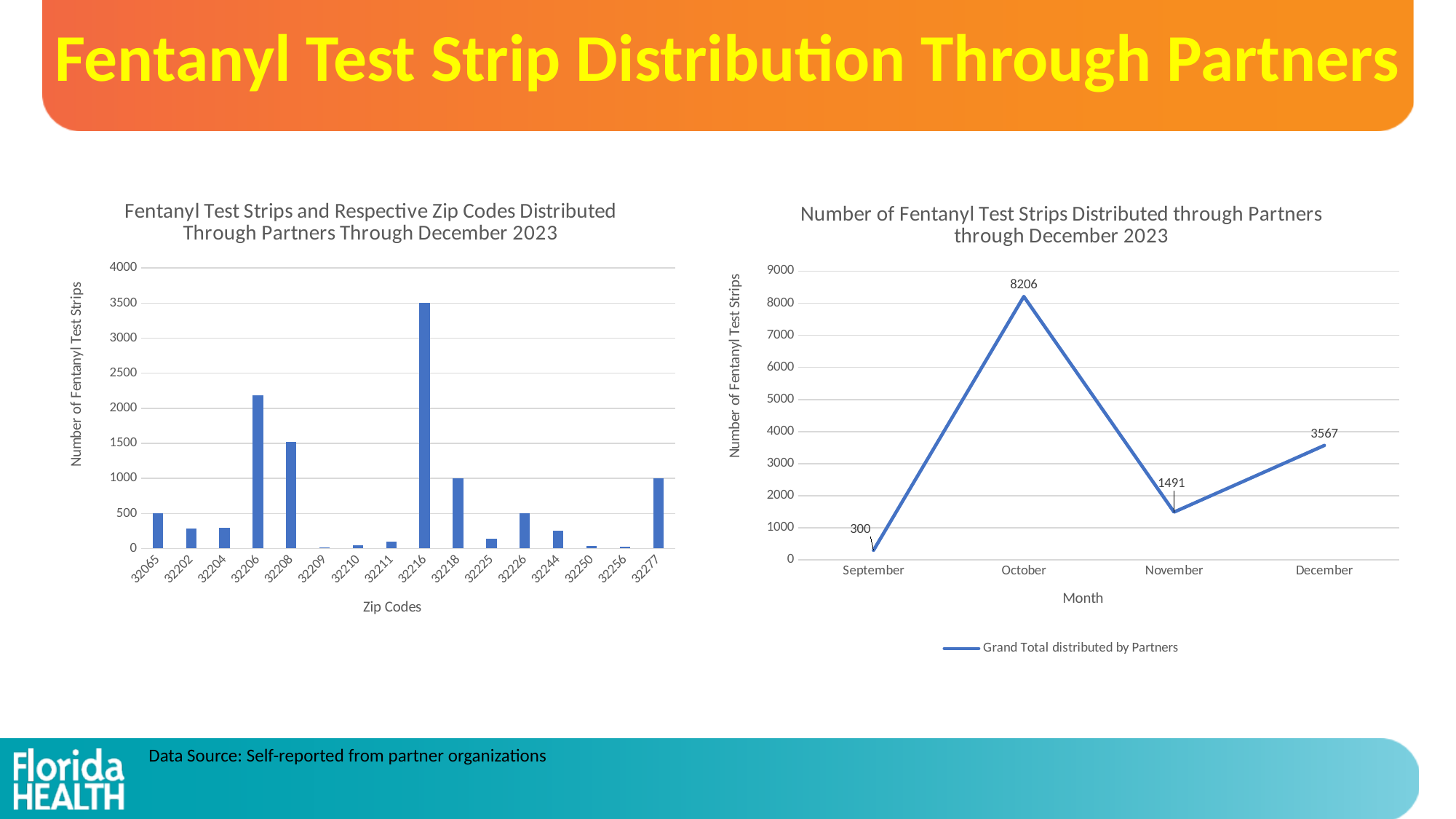
In the chart titled 'Number of Fentanyl Test Strips Distributed through Partners through December 2023', what is the difference between the October and November values? 6715 In the chart titled 'Number of Fentanyl Test Strips Distributed through Partners through December 2023', what is the value for September? 300 In the chart on the left, 'Fentanyl Test Strips and Respective Zip Codes Distributed Through Partners Through December 2023', which zip code has the highest number of test strips? 32216 In the chart titled 'Number of Fentanyl Test Strips Distributed through Partners through December 2023', what is the value for October? 8206 In the chart titled 'Number of Fentanyl Test Strips Distributed through Partners through December 2023', what kind of chart is it? Line chart In the chart titled 'Number of Fentanyl Test Strips Distributed through Partners through December 2023', which month has the highest value? October In the chart titled 'Number of Fentanyl Test Strips Distributed through Partners through December 2023', how many months are plotted? 4 In the chart titled 'Number of Fentanyl Test Strips Distributed through Partners through December 2023', what series name does the legend show? Grand Total distributed by Partners In the chart on the left, 'Fentanyl Test Strips and Respective Zip Codes Distributed Through Partners Through December 2023', how many zip codes are shown on the x axis? 16 In the chart on the left, 'Fentanyl Test Strips and Respective Zip Codes Distributed Through Partners Through December 2023', which is larger, the value for 32208 or the value for 32218? 32208 In the chart titled 'Number of Fentanyl Test Strips Distributed through Partners through December 2023', which month has the lowest value? September In the chart on the left, 'Fentanyl Test Strips and Respective Zip Codes Distributed Through Partners Through December 2023', is the value for zip code 32206 greater or less than 2000? greater